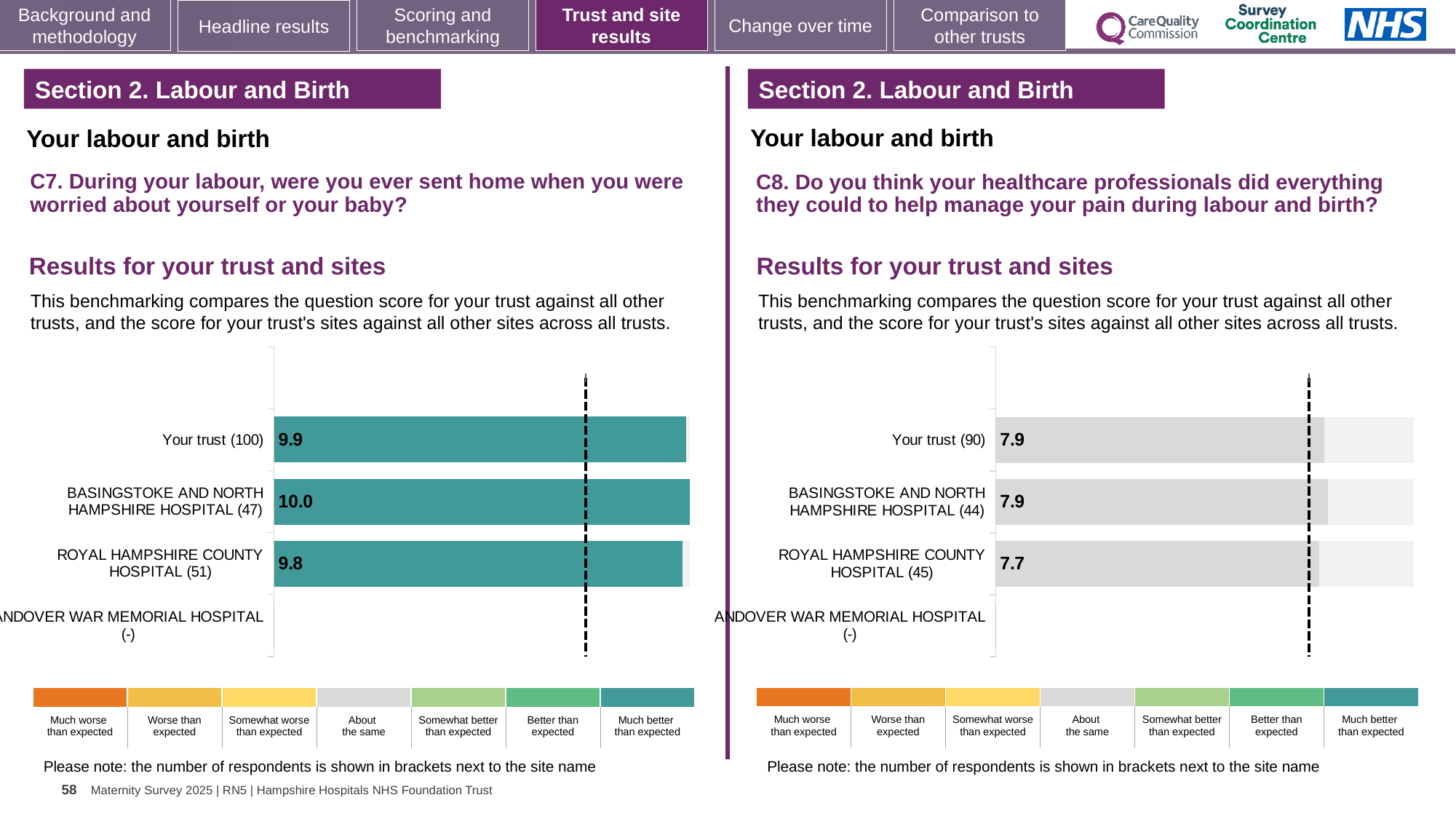
In the C8 chart on the right, what is the difference between the scores for Your trust and ROYAL HAMPSHIRE COUNTY HOSPITAL? 0.2 In the C7 chart on the left, what is the score for ROYAL HAMPSHIRE COUNTY HOSPITAL (51)? 9.8 In the C7 chart on the left, what is the score for BASINGSTOKE AND NORTH HAMPSHIRE HOSPITAL (47)? 10.0 In the C8 chart on the right, what is the score for ROYAL HAMPSHIRE COUNTY HOSPITAL (45)? 7.7 In the C7 chart on the left, what is the score for Your trust (100)? 9.9 In the C7 chart on the left, which site has the highest score? BASINGSTOKE AND NORTH HAMPSHIRE HOSPITAL (47) How many categories (rows) are listed on the y axis of the C8 chart on the right? 4 In the C8 chart on the right, which site has the lowest score among those with a value shown? ROYAL HAMPSHIRE COUNTY HOSPITAL (45) In the C8 chart on the right, what is the score for Your trust (90)? 7.9 In the C7 chart on the left, what is the difference between the scores for BASINGSTOKE AND NORTH HAMPSHIRE HOSPITAL and ROYAL HAMPSHIRE COUNTY HOSPITAL? 0.2 In the C8 chart on the right, is the score for BASINGSTOKE AND NORTH HAMPSHIRE HOSPITAL larger or smaller than the score for ROYAL HAMPSHIRE COUNTY HOSPITAL? larger What kind of chart is used in the C7 chart on the left? bar chart